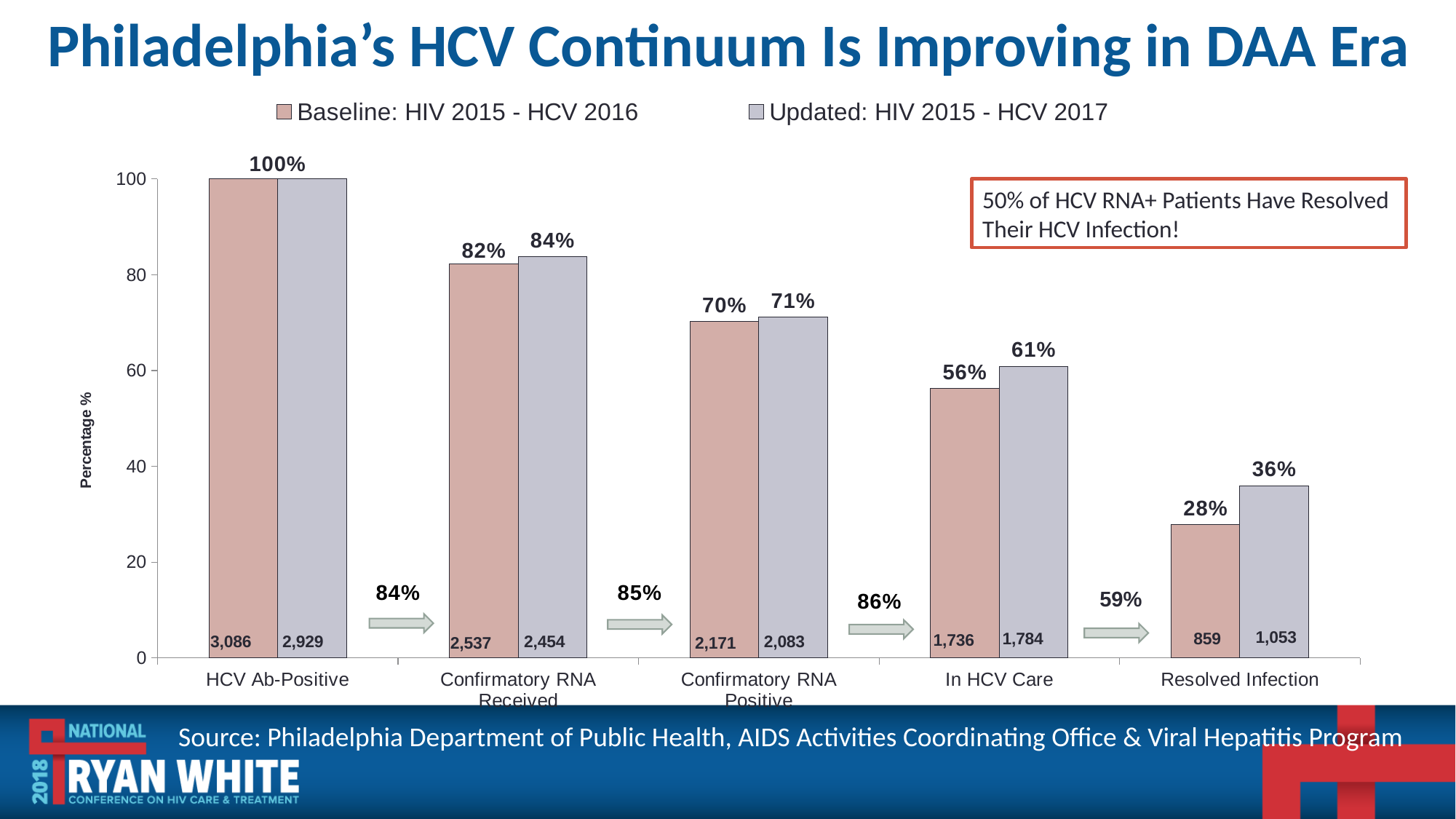
What is the Baseline: HIV 2015 - HCV 2016 percentage for In HCV Care? 56% How many categories are shown on the x axis? 5 What count is shown inside the Updated bar for HCV Ab-Positive? 2,929 What is the difference in percentage points between the Updated and Baseline values for Resolved Infection? 8 Which category has the lowest Updated: HIV 2015 - HCV 2017 percentage? Resolved Infection What kind of chart is shown on the slide? Bar chart What count is shown inside the Baseline bar for Confirmatory RNA Positive? 2,171 What is the Updated: HIV 2015 - HCV 2017 percentage for Resolved Infection? 36% Do the Updated: HIV 2015 - HCV 2017 percentages rise or fall from HCV Ab-Positive to Resolved Infection? Fall How many series does the legend list? 2 Which category has the highest Baseline: HIV 2015 - HCV 2016 percentage? HCV Ab-Positive For In HCV Care, which series has the larger percentage, Baseline or Updated? Updated: HIV 2015 - HCV 2017